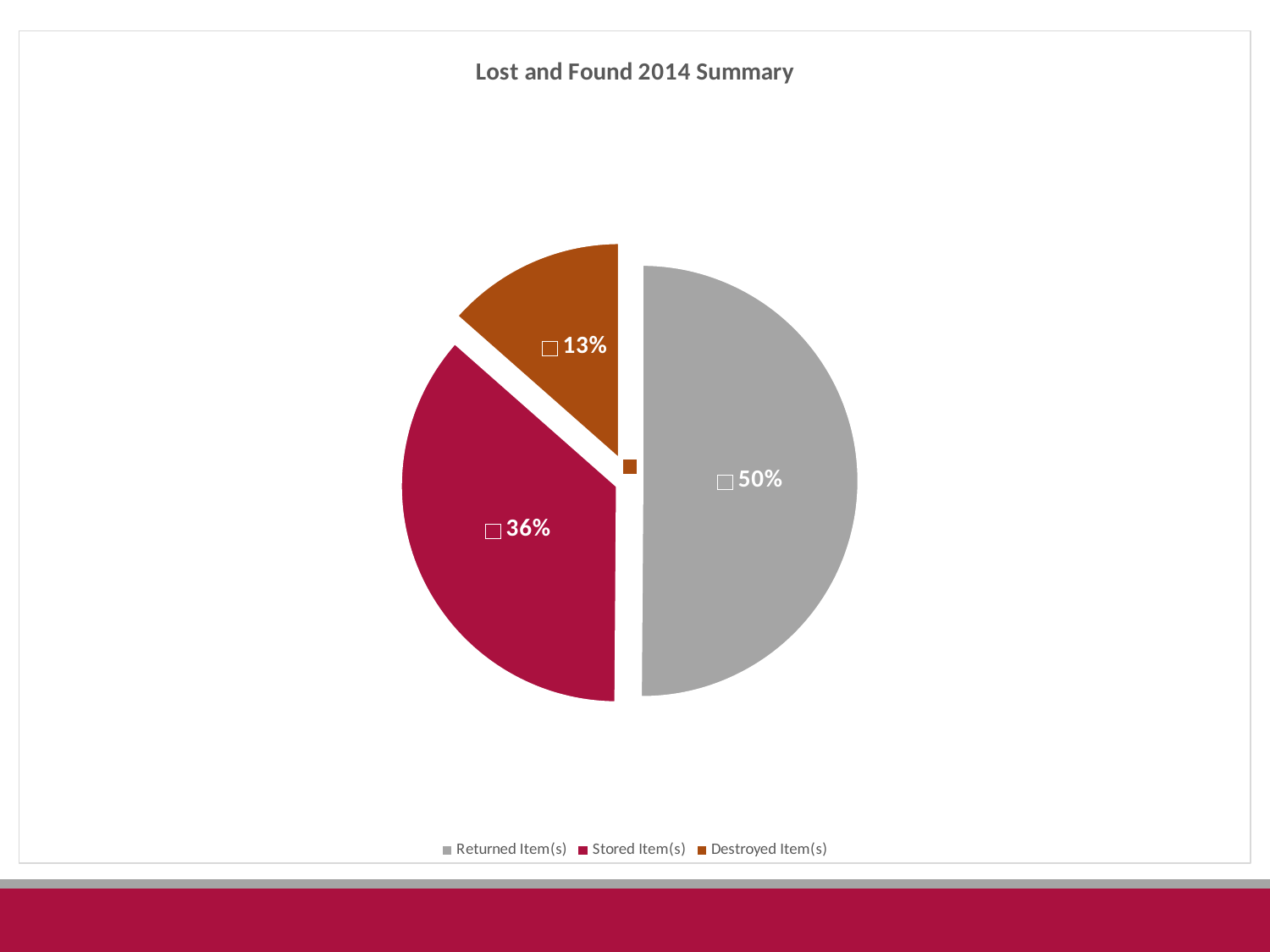
How many categories does the pie chart show? 3 What is the title of the chart? Lost and Found 2014 Summary What share of the pie does Returned Item(s) represent? 50% Which category has the smallest slice of the pie? Destroyed Item(s) What is the difference in percentage points between Stored Item(s) and Destroyed Item(s)? 23 What share of the pie does Destroyed Item(s) represent? 13% What kind of chart is shown on the slide? Pie chart Which is larger, the share for Stored Item(s) or the share for Destroyed Item(s)? Stored Item(s) What colour is the slice for Destroyed Item(s)? Brown/orange What share of the pie does Stored Item(s) represent? 36% What is the difference in percentage points between Returned Item(s) and Stored Item(s)? 14 Which category has the largest slice of the pie? Returned Item(s)